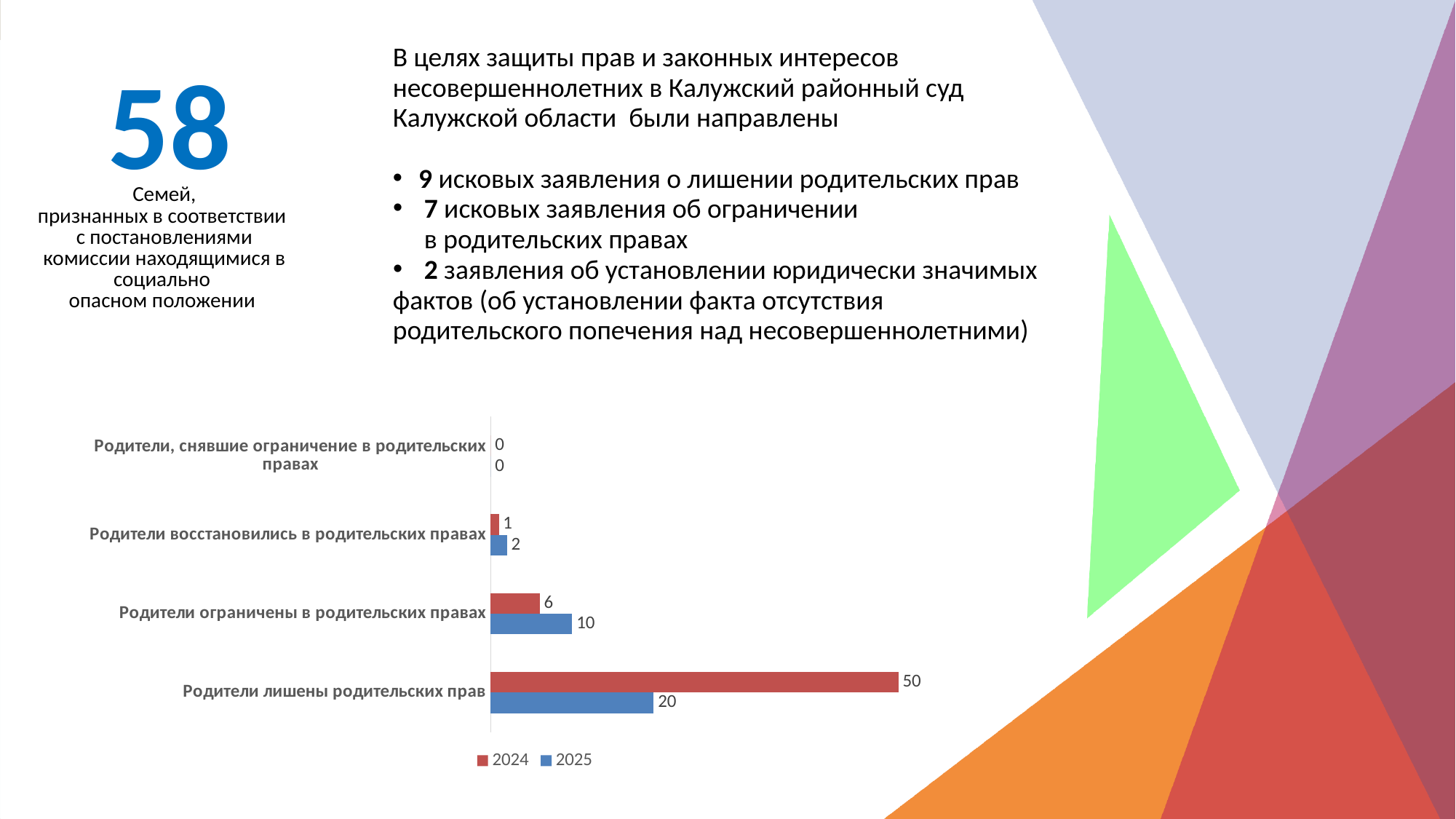
What is the difference between the 2025 and 2024 values for "Родители ограничены в родительских правах"? 4 How many series does the legend list? 2 What type of chart is shown on the slide? Bar chart What is the 2024 value for "Родители восстановились в родительских правах"? 1 Which category has the highest 2024 value? Родители лишены родительских прав What is the 2025 value for "Родители лишены родительских прав"? 20 Which category has the lowest 2025 value? Родители, снявшие ограничение в родительских правах What is the 2025 value for "Родители ограничены в родительских правах"? 10 For "Родители ограничены в родительских правах", which year has the larger value, 2024 or 2025? 2025 How many categories are shown in the chart? 4 What is the difference between the 2024 and 2025 values for "Родители лишены родительских прав"? 30 What is the 2024 value for "Родители лишены родительских прав"? 50